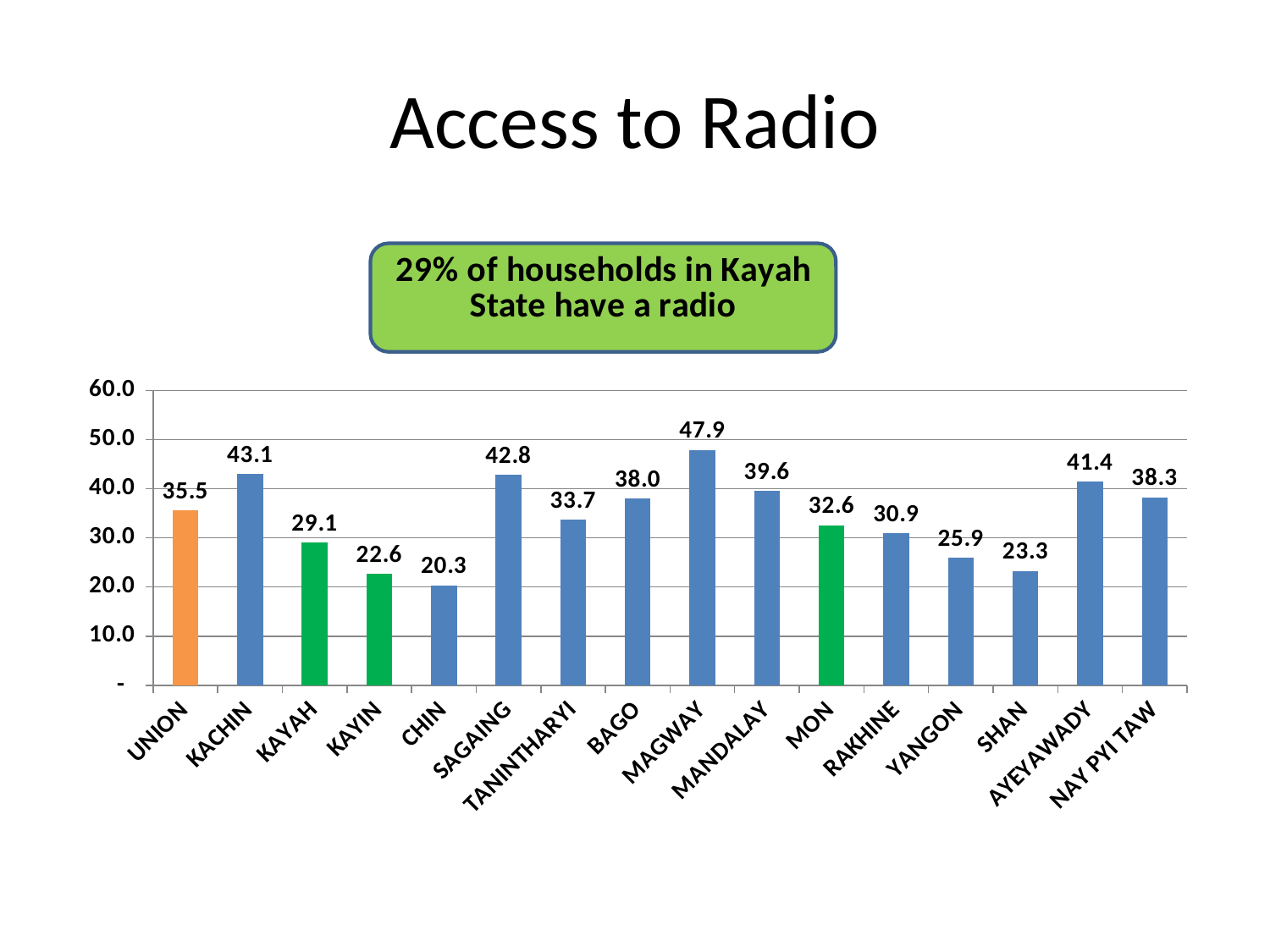
How many categories are shown on the x axis? 16 What is the value for Union? 35.5 Which category has the lowest value? Chin Which category has the highest value? Magway What colour is the bar for Union? orange What kind of chart is shown on the slide? bar chart What is the difference between the values for Kachin and Kayah? 14.0 What is the title of the slide? Access to Radio Is the value for Mon greater or less than 30.0? greater What is the value for Kayah? 29.1 What is the value for Magway? 47.9 Which is larger, the value for Sagaing or the value for Ayeyawady? Sagaing